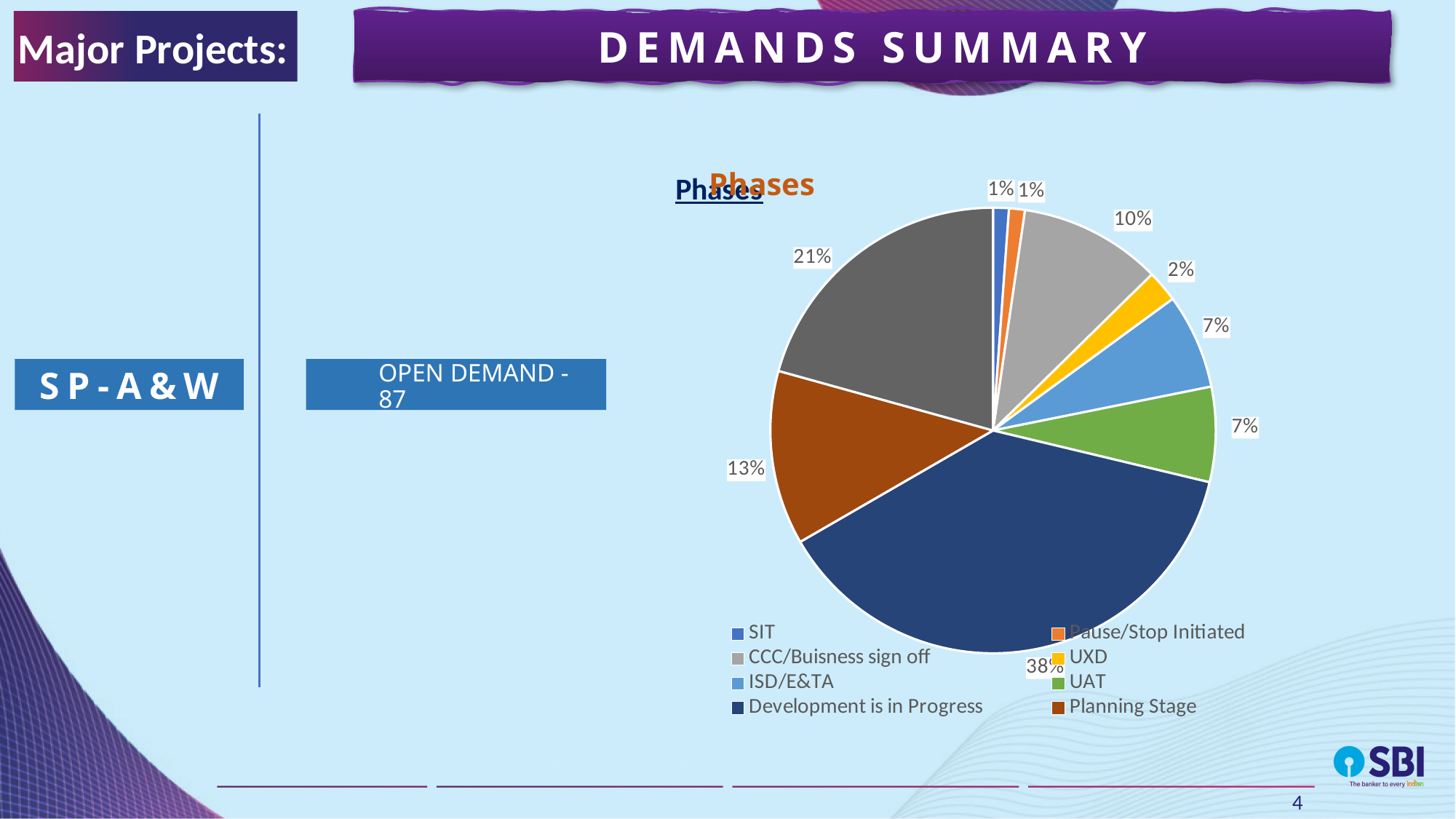
Which phase has the largest slice of the pie? Development is in Progress Which is larger, the slice for Planning Stage or the slice for CCC/Buisness sign off? Planning Stage What percentage is shown for Planning Stage? 13% What is the difference in percentage points between Development is in Progress and Planning Stage? 25 What percentage is shown for UXD? 2% What is the title of the pie chart? Phases How many entries does the legend of the pie chart list? 8 What percentage is shown for UAT? 7% What share of the pie does Development is in Progress represent? 38% What percentage is shown for ISD/E&TA? 7% What kind of chart is shown on the slide? Pie chart What percentage is shown for CCC/Buisness sign off? 10%